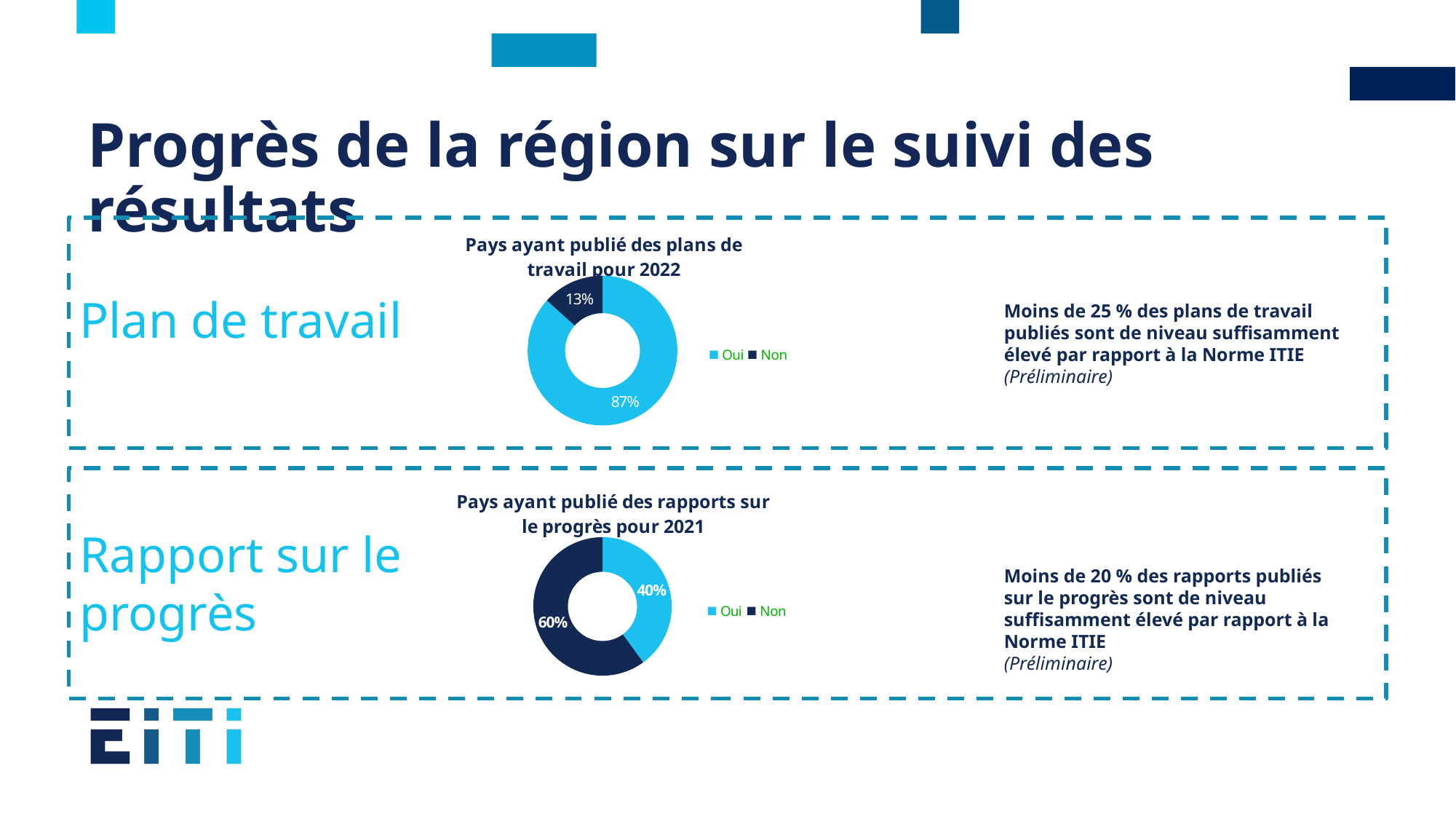
In the chart 'Pays ayant publié des plans de travail pour 2022', what share is labelled for 'Non'? 13% In the chart 'Pays ayant publié des plans de travail pour 2022', what colour is the 'Non' slice? Dark navy blue How many categories does the legend of the chart 'Pays ayant publié des rapports sur le progrès pour 2021' list? 2 In the chart 'Pays ayant publié des rapports sur le progrès pour 2021', which slice is the smallest? Oui In the chart 'Pays ayant publié des rapports sur le progrès pour 2021', which is larger, 'Oui' or 'Non'? Non In the chart 'Pays ayant publié des rapports sur le progrès pour 2021', what is the difference between the 'Non' and 'Oui' shares? 20% In the chart 'Pays ayant publié des plans de travail pour 2022', what share is labelled for 'Oui'? 87% In the chart 'Pays ayant publié des rapports sur le progrès pour 2021', what share is labelled for 'Non'? 60% What kind of chart is 'Pays ayant publié des plans de travail pour 2022'? Doughnut chart In the chart 'Pays ayant publié des plans de travail pour 2022', which slice is the largest? Oui In the chart 'Pays ayant publié des plans de travail pour 2022', what is the difference between the 'Oui' and 'Non' shares? 74% In the chart 'Pays ayant publié des rapports sur le progrès pour 2021', what share is labelled for 'Oui'? 40%